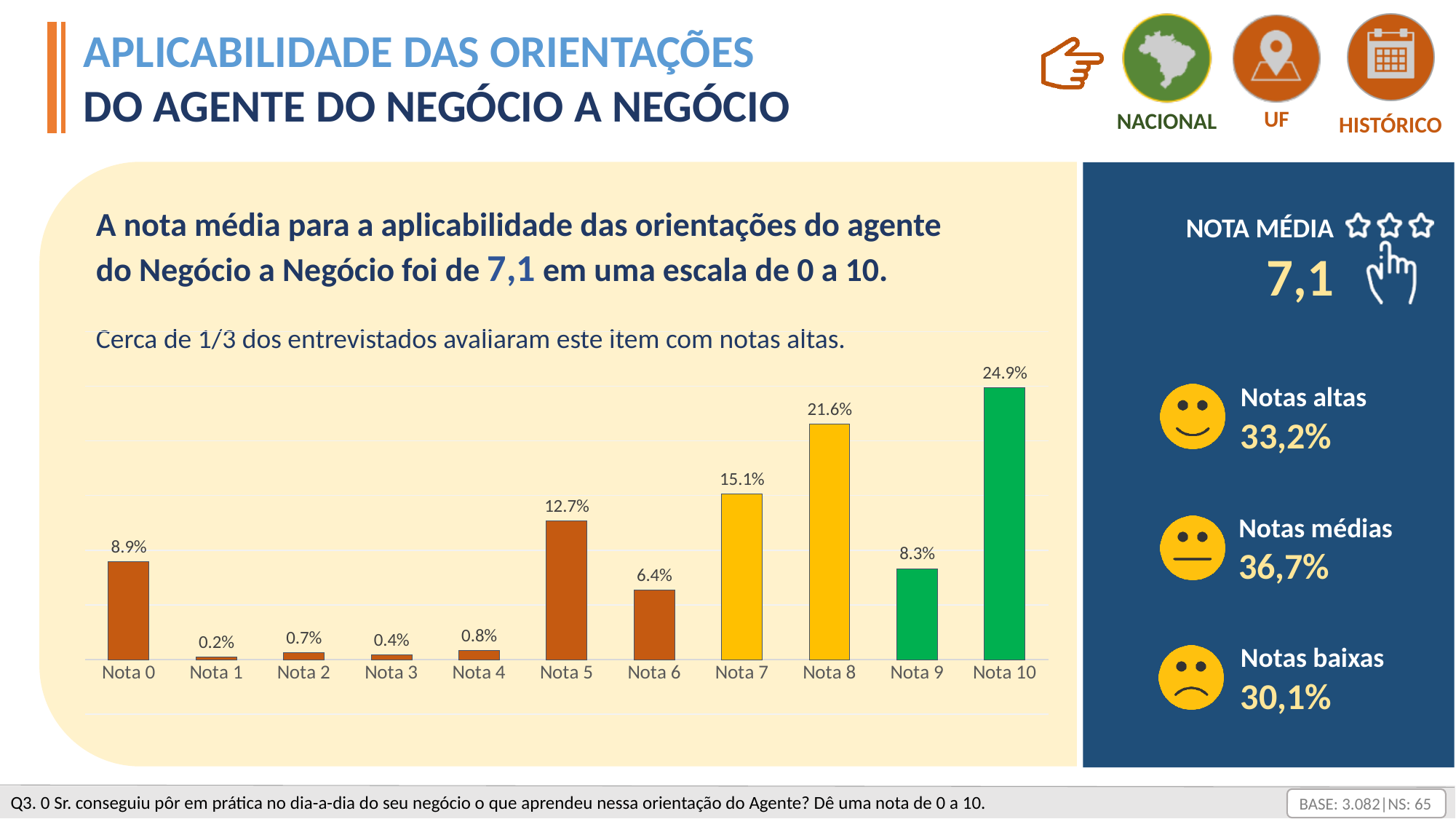
Which category has the highest value? Nota 10 What is the difference between the values for Nota 0 and Nota 9? 0.6% How many categories are shown on the x axis? 11 What kind of chart is shown on the slide? Bar chart What is the difference between the values for Nota 10 and Nota 8? 3.3% What is the total of the values for Nota 9 and Nota 10? 33.2% What is the value for Nota 10? 24.9% What colour are the bars for Nota 7 and Nota 8? Yellow What is the value for Nota 5? 12.7% Which category has the lowest value? Nota 1 Which is larger, the value for Nota 7 or the value for Nota 6? Nota 7 What is the value for Nota 1? 0.2%